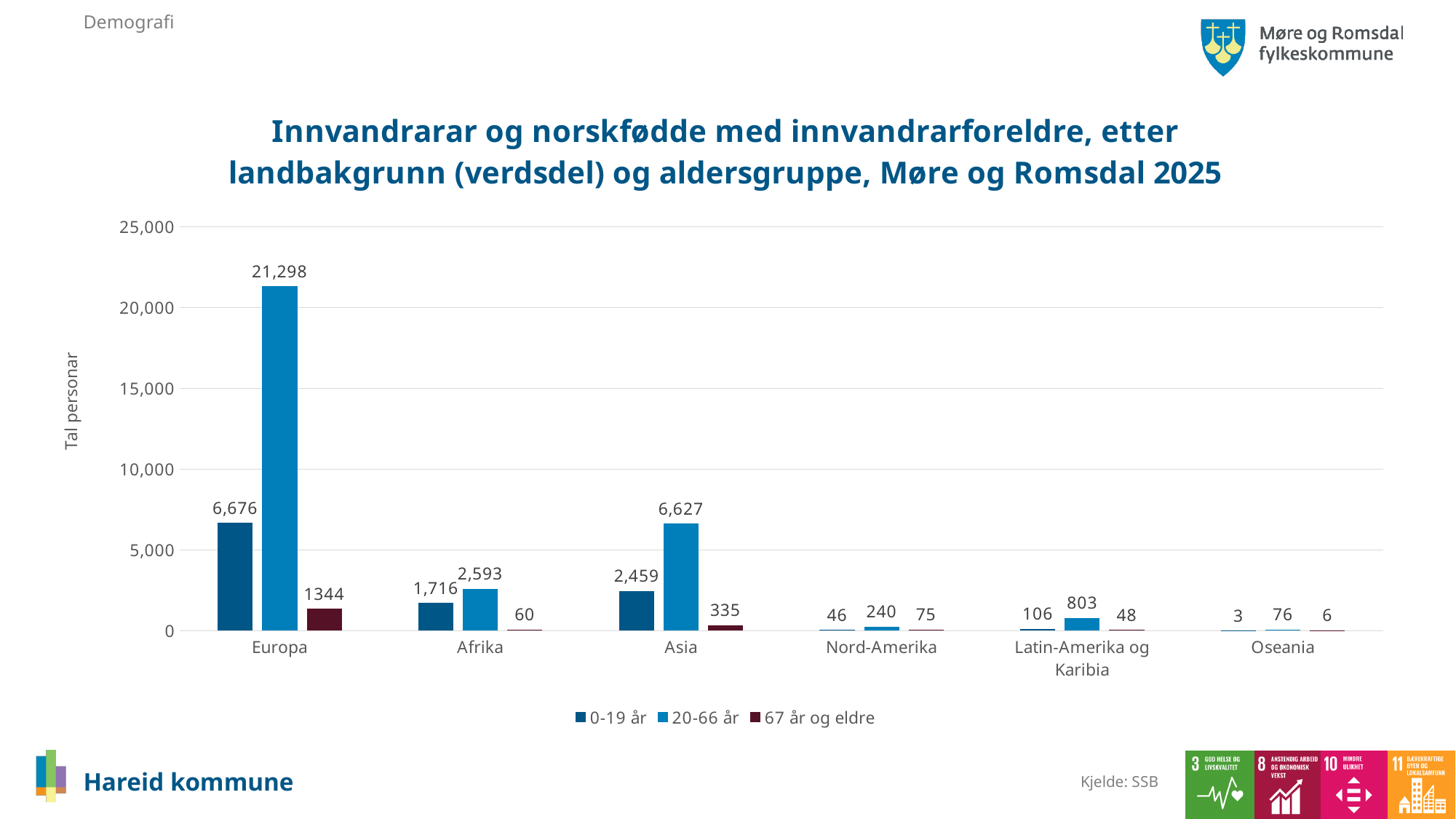
Which category has the lowest value in the 0-19 år series? Oseania Which category has the highest value in the 20-66 år series? Europa Is the 20-66 år value for Europa greater or less than 20,000? greater What kind of chart is shown on the slide? Bar chart What is the value for the 67 år og eldre series for Afrika? 60 How many series does the legend list? 3 What is the value for the 20-66 år series for Europa? 21,298 How many categories (world regions) are shown on the x axis? 6 What is the difference between the 20-66 år values for Asia and Afrika? 4,034 What is the value for the 0-19 år series for Asia? 2,459 Which is larger: the 0-19 år value for Europa or the 20-66 år value for Asia? 0-19 år value for Europa What is the value for the 20-66 år series for Latin-Amerika og Karibia? 803